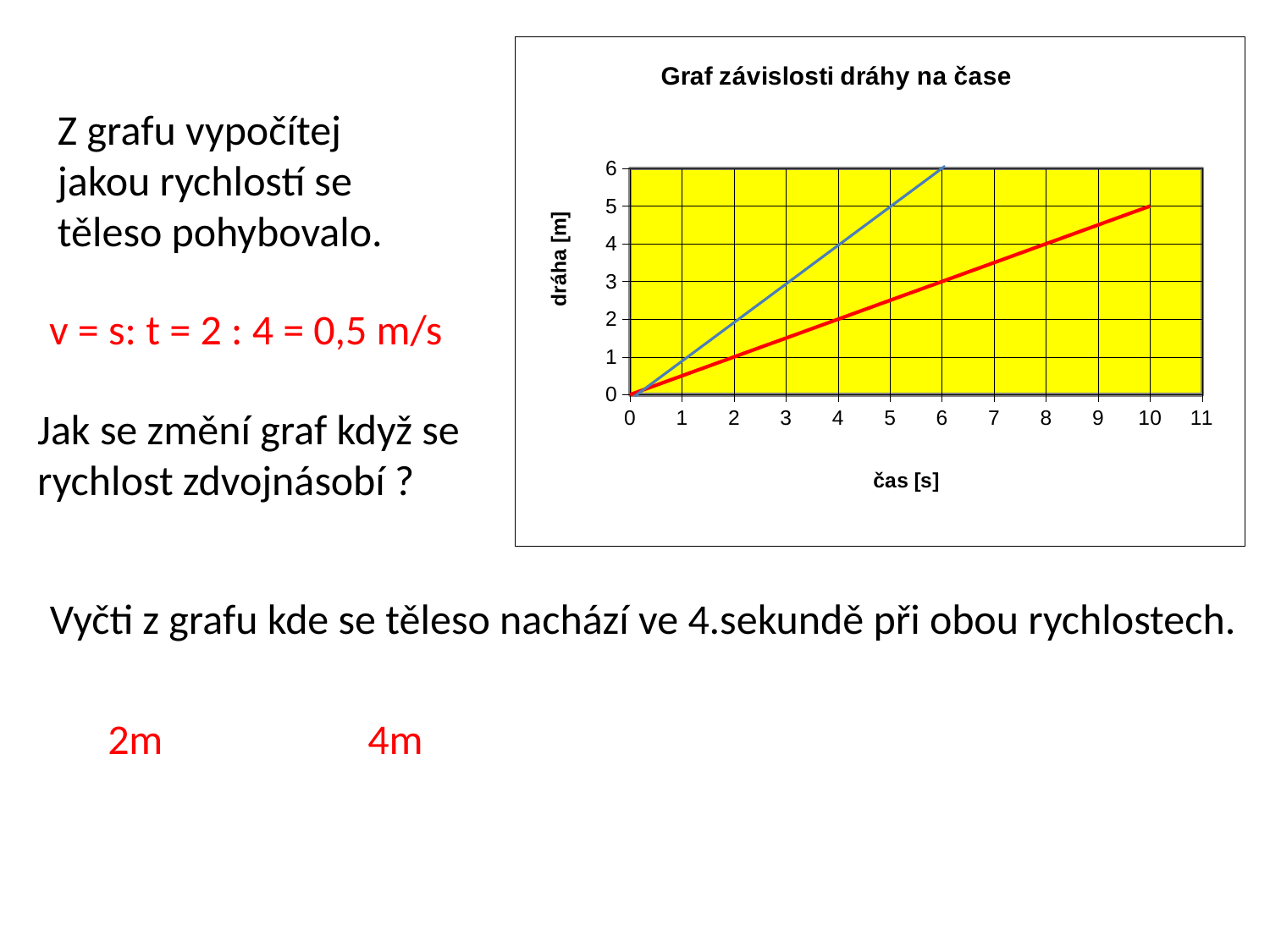
What is the value of dráha for the red line at čas = 10 s? 5 What is the difference between the blue line and the red line values of dráha at čas = 4 s? 2 Is the value of the red line at čas = 8 s greater or less than 5? less At čas = 4 s, which line shows the larger dráha value, the red line or the blue line? the blue line According to the chart, what is the value of dráha for the red line at čas = 4 s? 2 According to the chart, what is the value of dráha for the blue line at čas = 4 s? 4 What is the label of the vertical axis of the chart? dráha [m] How many lines are plotted on the chart? 2 What kind of chart is shown on the slide? line chart What is the value of dráha for the blue line at čas = 6 s? 6 What is the title of the chart? Graf závislosti dráhy na čase Do the values of dráha rise or fall as čas increases along the x axis? rise